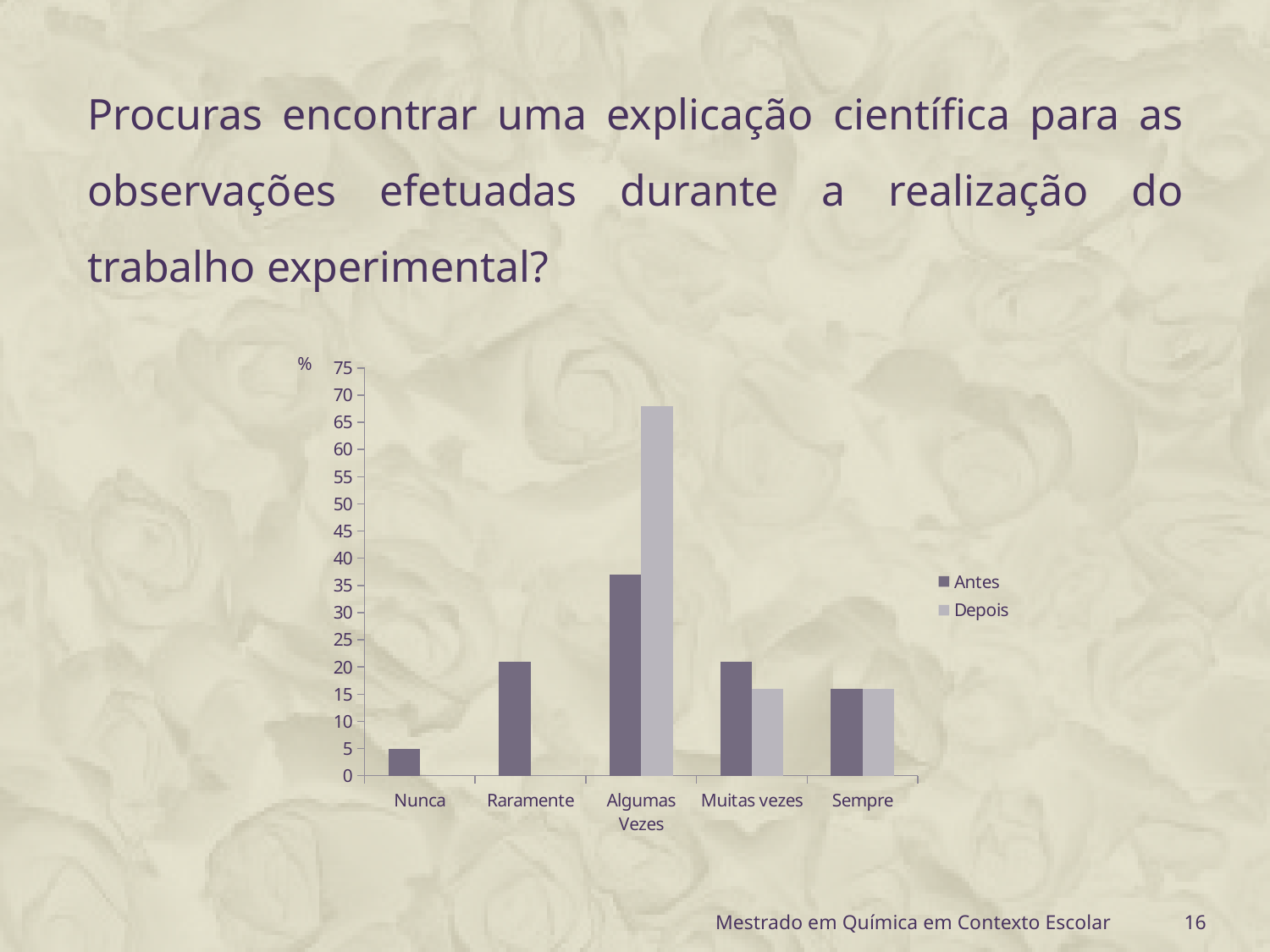
Is the Depois value for Algumas Vezes greater or less than 60? greater Is the Antes value for Algumas Vezes greater or less than 30? greater Is the Antes value for Raramente greater or less than 25? less How many categories are shown on the x axis? 5 How many series does the legend list? 2 For Algumas Vezes, which series has the larger value, Antes or Depois? Depois What kind of chart is shown on the slide? bar chart What are the two entries listed in the chart legend? Antes and Depois Which category has the highest value for the Depois series? Algumas Vezes For Muitas vezes, which series has the larger value, Antes or Depois? Antes Which category has the highest value for the Antes series? Algumas Vezes Which category has the lowest value for the Antes series? Nunca